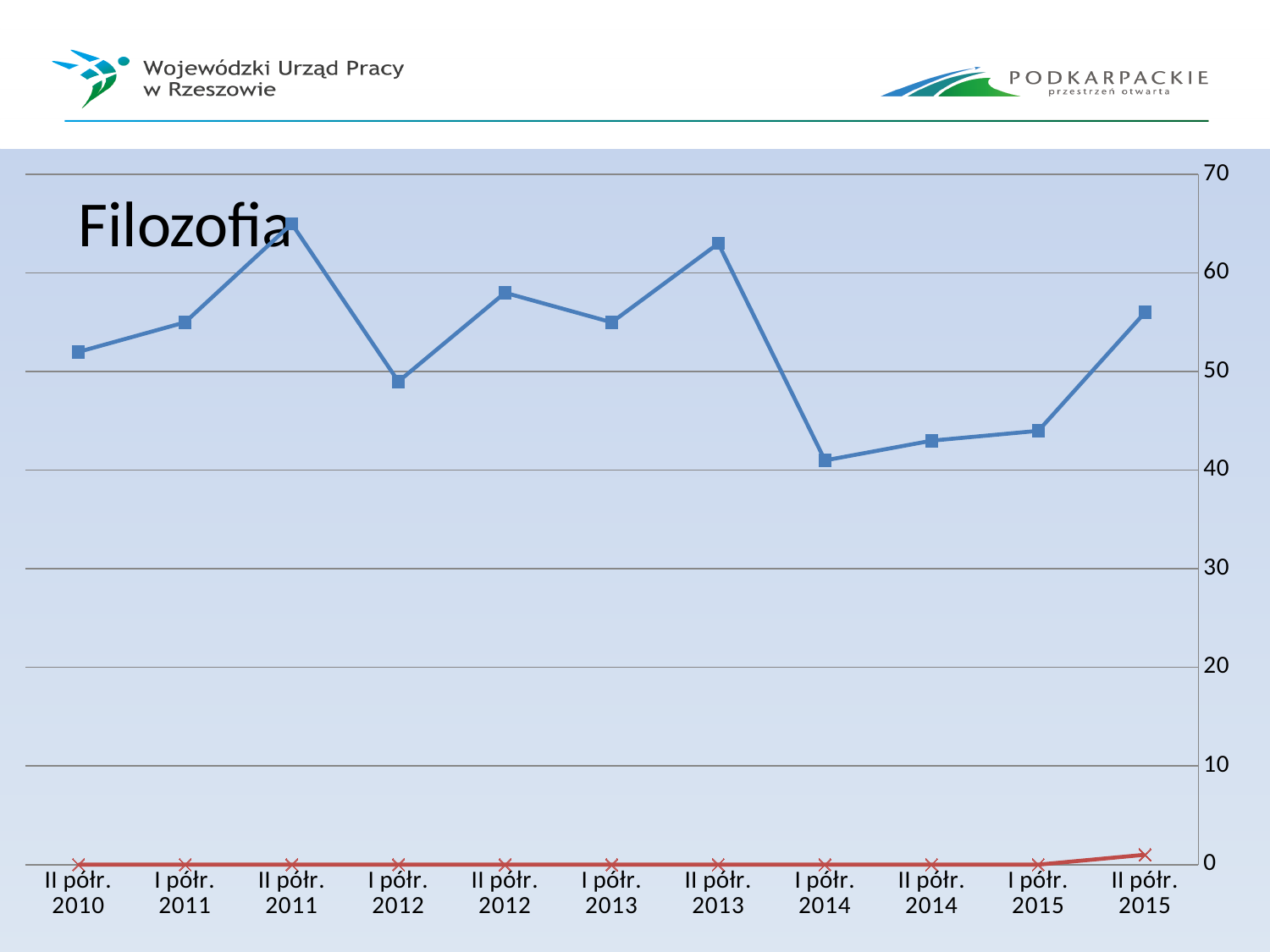
Is the value of the blue line for I półr. 2015 greater or less than 50? less Is the value of the blue line for I półr. 2014 greater or less than 40? greater How many lines are plotted on the chart? 2 Is the value of the blue line for I półr. 2012 greater or less than 50? less On the blue line, which is larger: the value for I półr. 2011 or the value for I półr. 2012? I półr. 2011 Does the blue line rise or fall from I półr. 2014 to II półr. 2015? rise What kind of chart is shown on the slide? line chart In which period does the blue line reach its highest value? II półr. 2011 How many time periods are plotted along the x axis? 11 What is the title of the chart? Filozofia